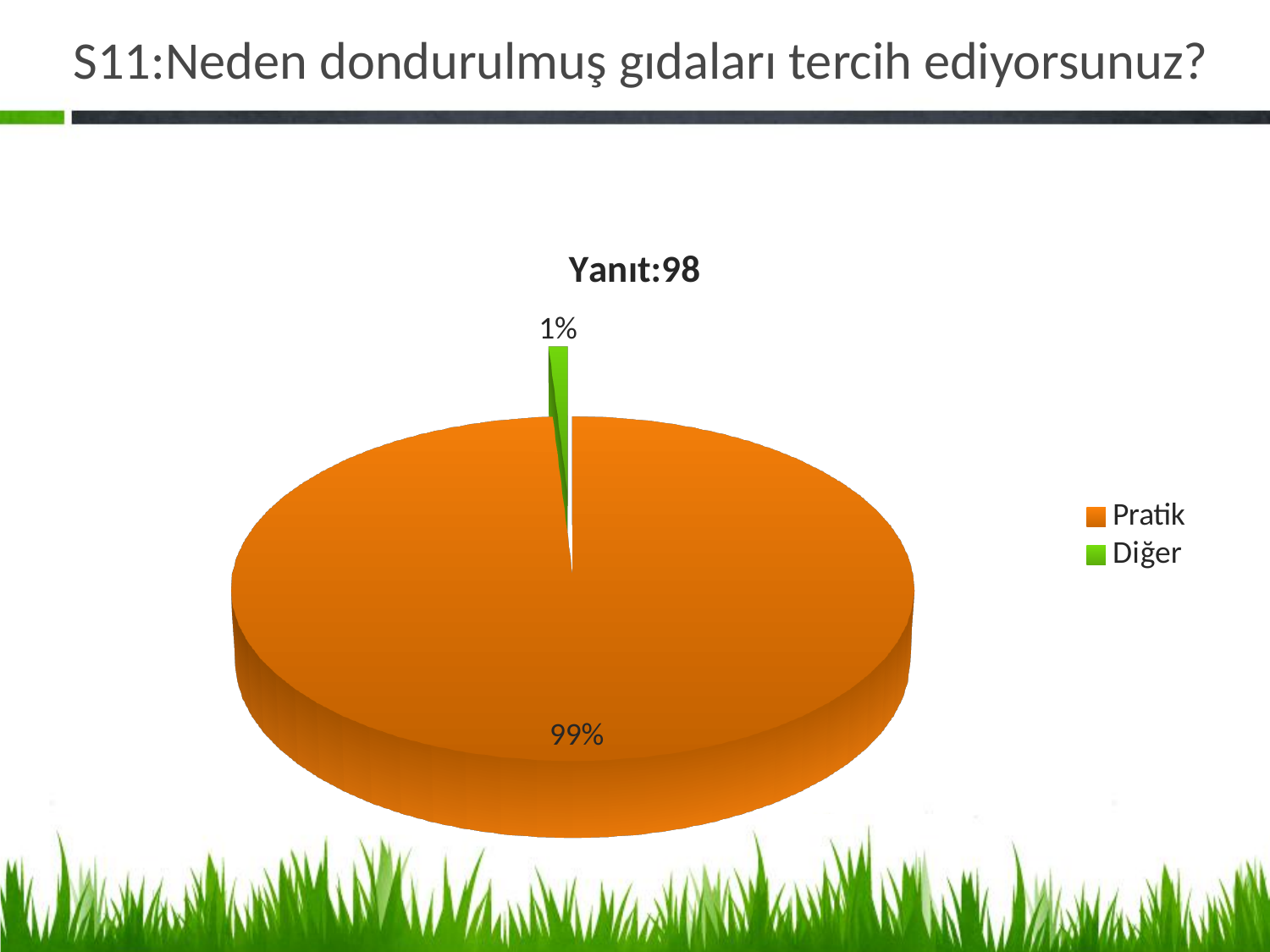
How many slices does the pie chart have? 2 Which category has the largest slice? Pratik What share of the pie does Diğer have? 1% What colour is the Diğer slice? green Which is larger, the slice for Pratik or the slice for Diğer? Pratik Which category has the smallest slice? Diğer What is the chart's title? Yanıt:98 What is the difference in percentage points between Pratik and Diğer? 98 What share of the pie does Pratik have? 99% How many entries does the legend list? 2 What kind of chart is shown on the slide? pie chart